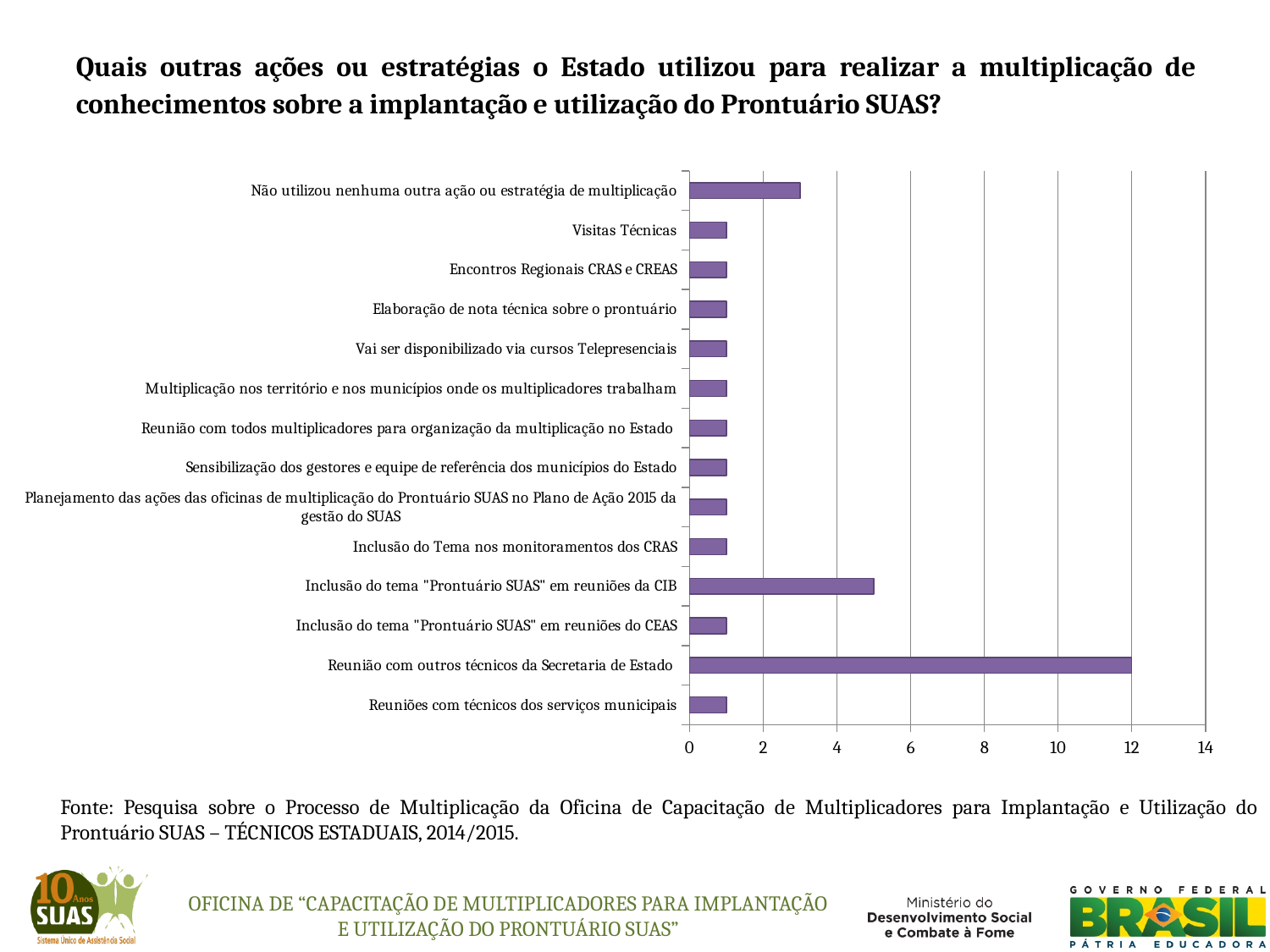
What is the value for "Reunião com outros técnicos da Secretaria de Estado"? 12 Which category has the highest value in the chart? Reunião com outros técnicos da Secretaria de Estado How many categories are plotted in the chart? 14 What kind of chart is shown on the slide? bar chart Which is larger: the value for "Inclusão do tema "Prontuário SUAS" em reuniões da CIB" or the value for "Não utilizou nenhuma outra ação ou estratégia de multiplicação"? Inclusão do tema "Prontuário SUAS" em reuniões da CIB Which is larger: the value for "Reunião com outros técnicos da Secretaria de Estado" or the value for "Reuniões com técnicos dos serviços municipais"? Reunião com outros técnicos da Secretaria de Estado Is the value for "Inclusão do tema "Prontuário SUAS" em reuniões da CIB" greater or less than 4? greater Is the value for "Inclusão do tema "Prontuário SUAS" em reuniões da CIB" greater or less than 6? less Is the value for "Não utilizou nenhuma outra ação ou estratégia de multiplicação" greater or less than 4? less What is the highest value shown on the horizontal axis of the chart? 14